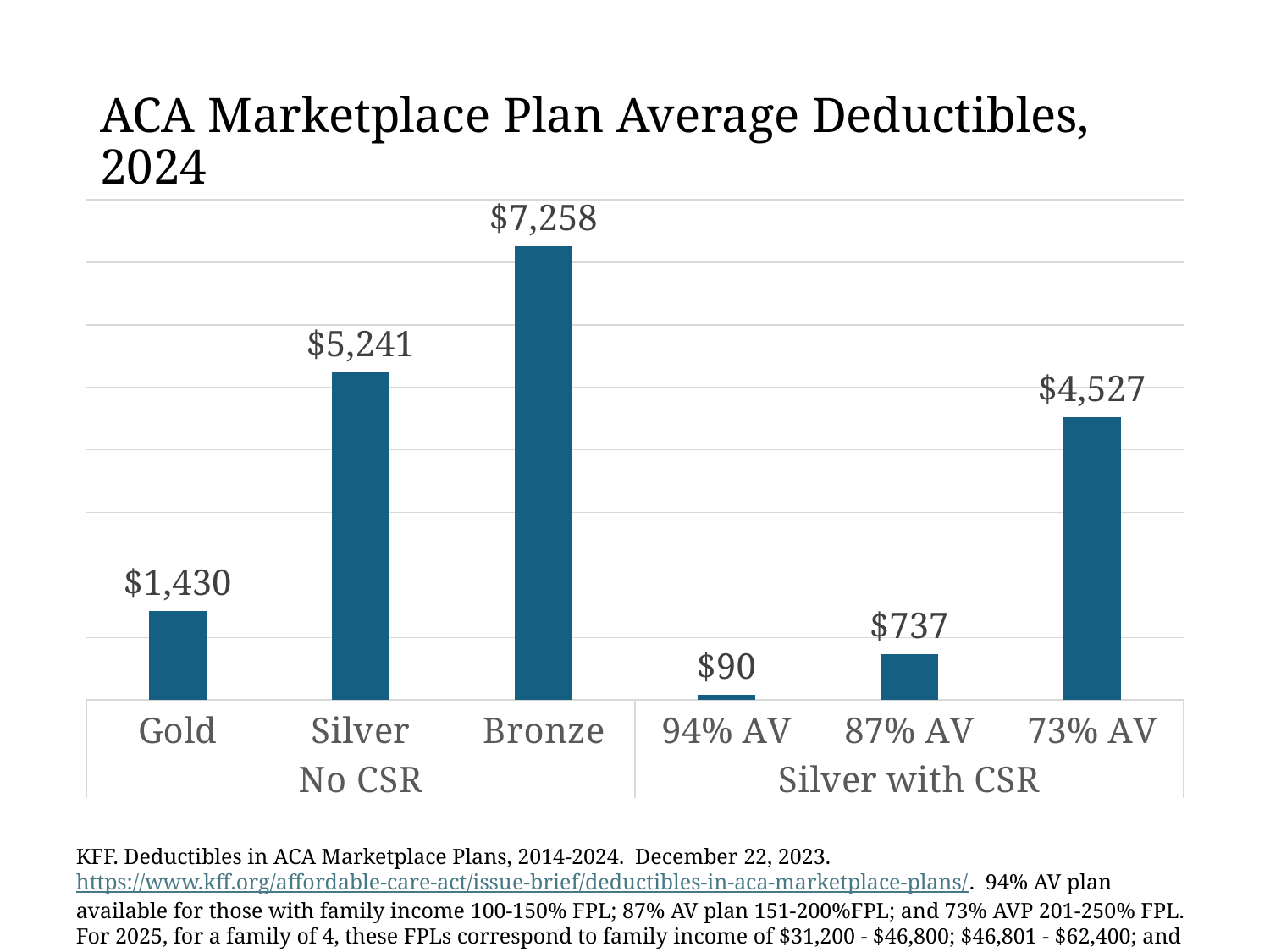
What is the average deductible for the 94% AV Silver plan with CSR? $90 What is the difference between the Bronze deductible and the Gold deductible? $5,828 What is the average deductible for the Gold plan? $1,430 What is the difference between the Silver (No CSR) deductible and the 73% AV Silver with CSR deductible? $714 What kind of chart is shown on the slide? Bar chart Which plan category has the lowest average deductible? 94% AV What is the title of the chart? ACA Marketplace Plan Average Deductibles, 2024 What is the average deductible for the 73% AV Silver plan with CSR? $4,527 Which has a larger average deductible, the 87% AV plan or the Gold plan? Gold Which plan category has the highest average deductible? Bronze What is the average deductible for the Silver plan with no CSR? $5,241 How many plan categories are shown in the chart? 6